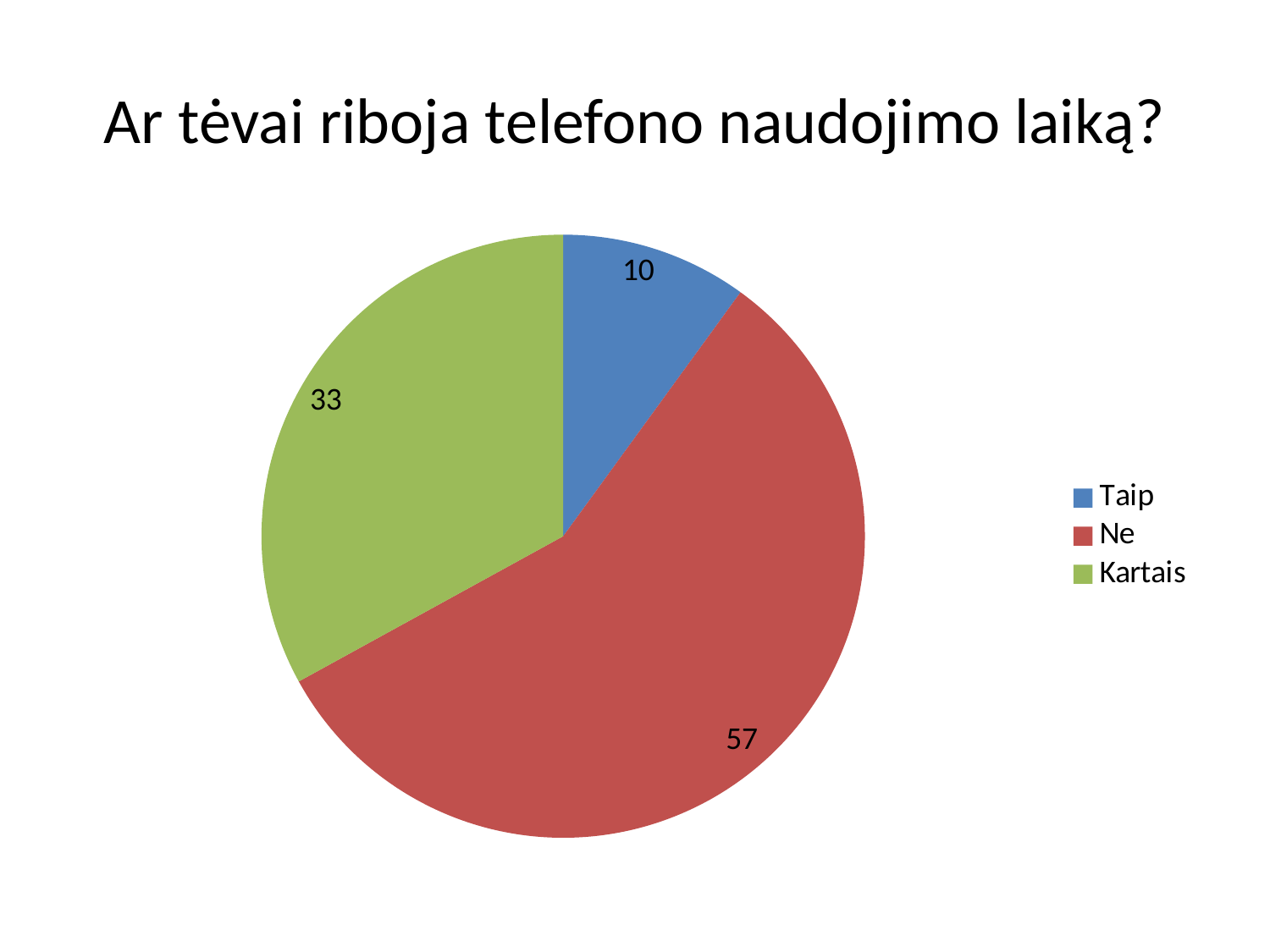
What is the difference between the values for Ne and Kartais? 24 What is the value for Kartais? 33 What kind of chart is shown on the slide? pie chart What is the title of the chart? Ar tėvai riboja telefono naudojimo laiką? Which category has the largest slice? Ne Which is larger, the value for Kartais or the value for Taip? Kartais What is the difference between the values for Kartais and Taip? 23 How many slices does the pie chart have? 3 What share of the pie does the Ne slice represent? 57% What is the value for Taip? 10 Which category has the smallest slice? Taip What is the value for Ne? 57